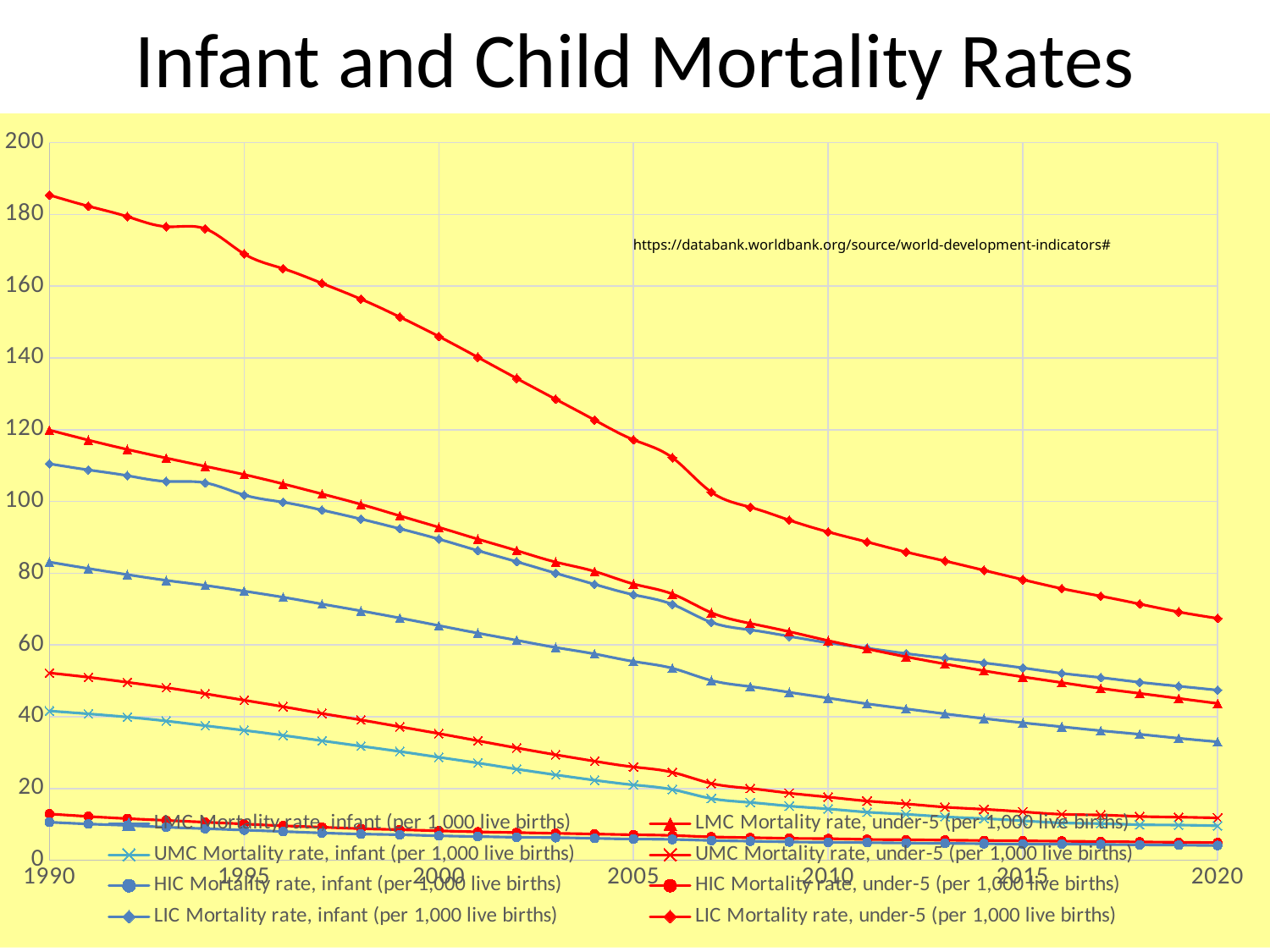
What kind of chart is shown on the slide? line chart Is the value for LIC Mortality rate, under-5 in 1990 greater or less than 180? greater Is the value for LMC Mortality rate, infant in 2020 greater or less than 40? less Which series has the lowest value in 2020? HIC Mortality rate, infant (per 1,000 live births) How many series does the legend list? 8 Is the value for LIC Mortality rate, under-5 in 2020 greater or less than 60? greater In 2010, which is larger: LIC Mortality rate, under-5 or LMC Mortality rate, under-5? LIC Mortality rate, under-5 Which series has the highest value in 1990? LIC Mortality rate, under-5 (per 1,000 live births) What is the source URL shown on the chart? https://databank.worldbank.org/source/world-development-indicators# What is the title of the chart? Infant and Child Mortality Rates Do the mortality rates rise or fall from 1990 to 2020? fall